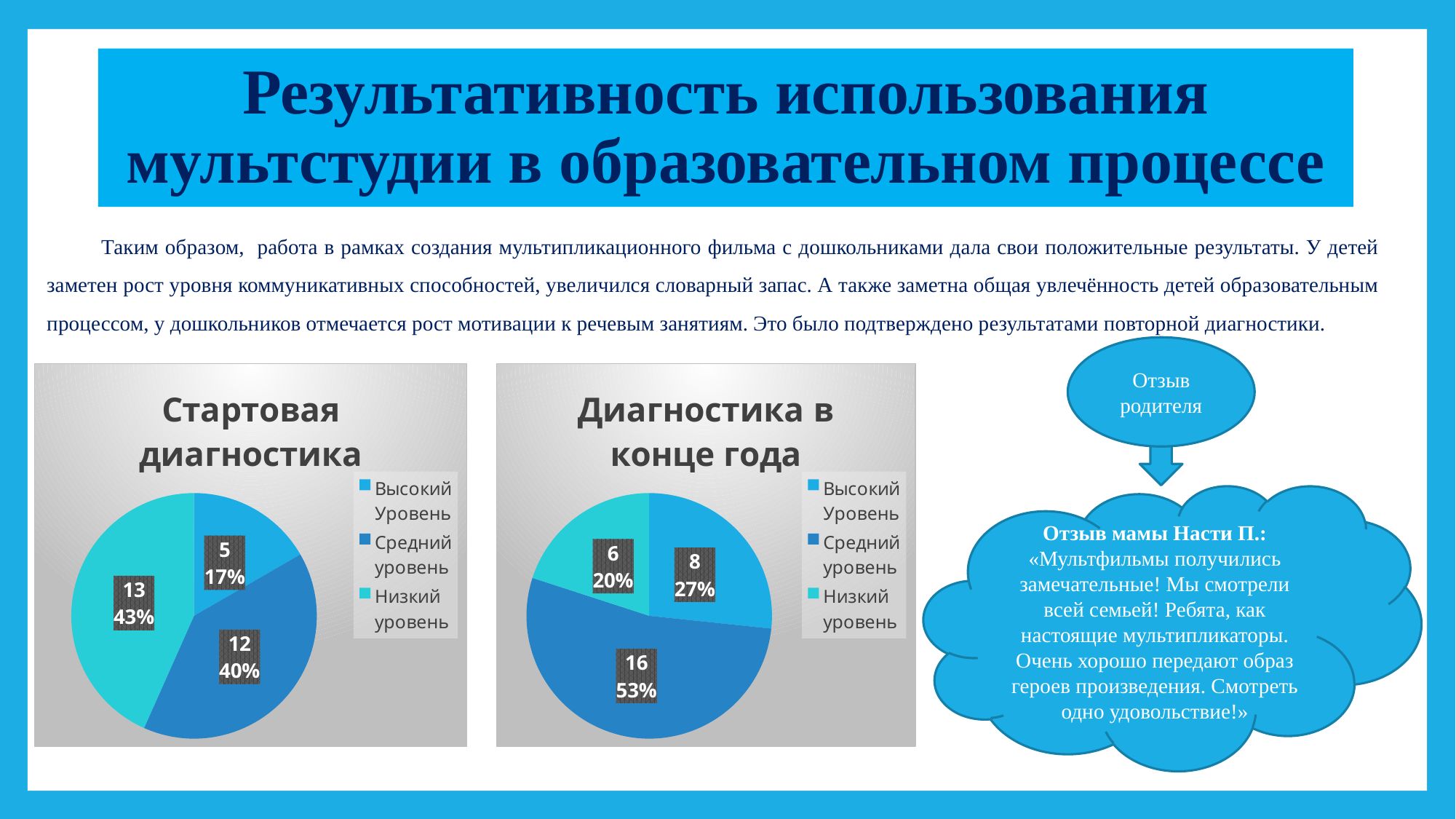
What type of chart is "Стартовая диагностика"? Pie chart In the "Стартовая диагностика" chart, what percentage is shown for "Высокий Уровень"? 17% In the "Диагностика в конце года" chart, what value is shown for "Средний уровень"? 16 In the "Стартовая диагностика" chart, which category has the largest slice? Низкий уровень How many categories does the "Диагностика в конце года" chart show? 3 In the "Стартовая диагностика" chart, which is larger: the value for "Средний уровень" or "Высокий Уровень"? Средний уровень In the "Стартовая диагностика" chart, what value is shown for "Низкий уровень"? 13 In the "Диагностика в конце года" chart, which category has the smallest slice? Низкий уровень In the "Диагностика в конце года" chart, what percentage is shown for "Низкий уровень"? 20% What is the total of the values shown in the "Стартовая диагностика" chart? 30 What is the title of the chart on the left of the slide? Стартовая диагностика In the "Диагностика в конце года" chart, what is the difference between the values for "Средний уровень" and "Высокий Уровень"? 8